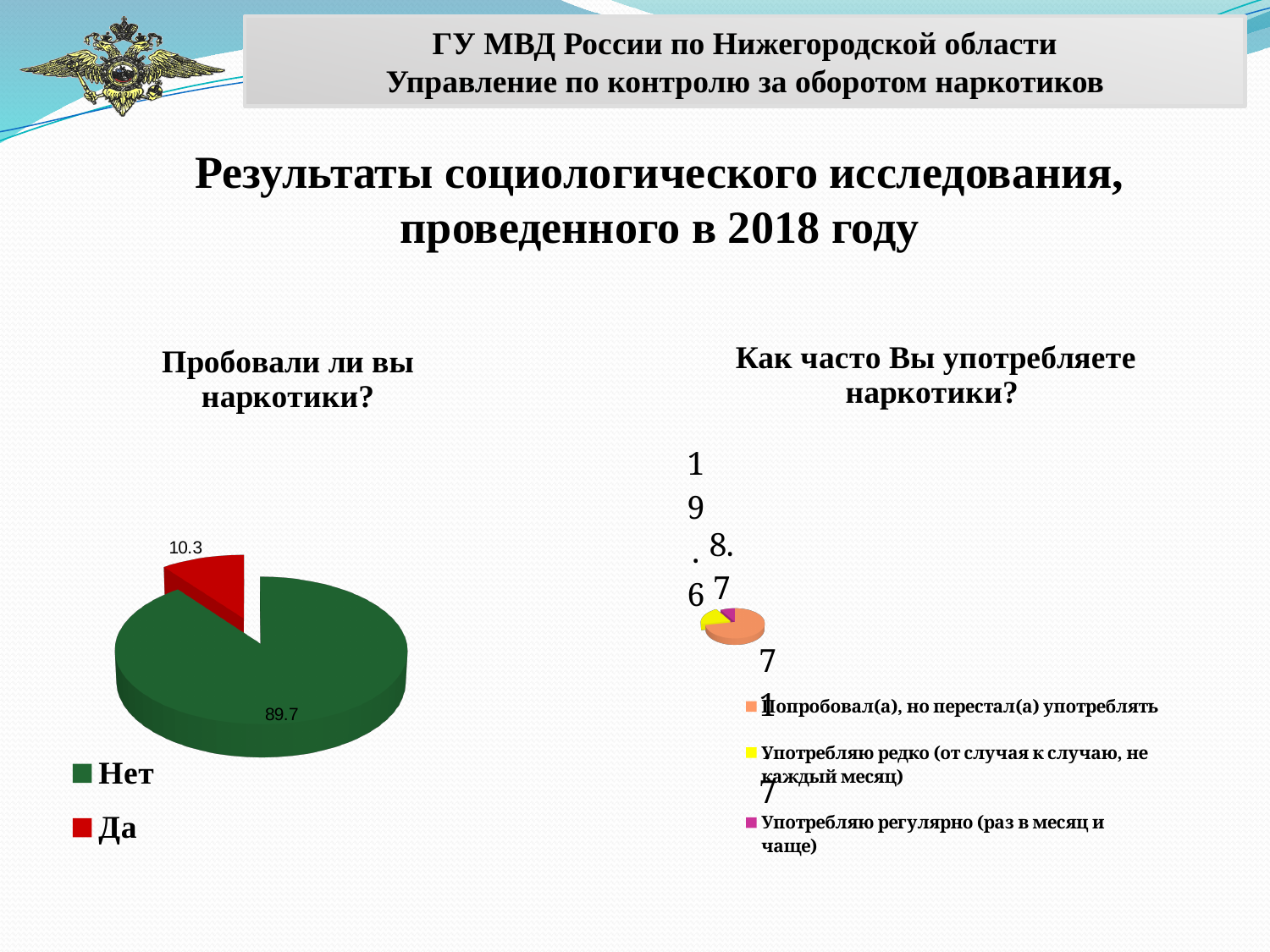
What kind of chart is the one titled "Как часто Вы употребляете наркотики?"? Pie chart In the chart titled "Пробовали ли вы наркотики?", how many categories are shown? 2 What kind of chart is the one titled "Пробовали ли вы наркотики?"? Pie chart In the chart titled "Пробовали ли вы наркотики?", what is the difference between the values for "Нет" and "Да"? 79.4 In the chart titled "Пробовали ли вы наркотики?", which category has the largest slice? Нет In the chart titled "Пробовали ли вы наркотики?", what is the value for "Нет"? 89.7 In the chart titled "Как часто Вы употребляете наркотики?", which category has the largest slice? Попробовал(а), но перестал(а) употреблять In the chart titled "Пробовали ли вы наркотики?", what is the value for "Да"? 10.3 In the chart titled "Как часто Вы употребляете наркотики?", how many entries does the legend list? 3 In the chart titled "Пробовали ли вы наркотики?", which category has the smallest slice? Да In the chart titled "Пробовали ли вы наркотики?", which is larger, the value for "Да" or the value for "Нет"? Нет In the chart titled "Пробовали ли вы наркотики?", what colour is the slice for "Да"? Red